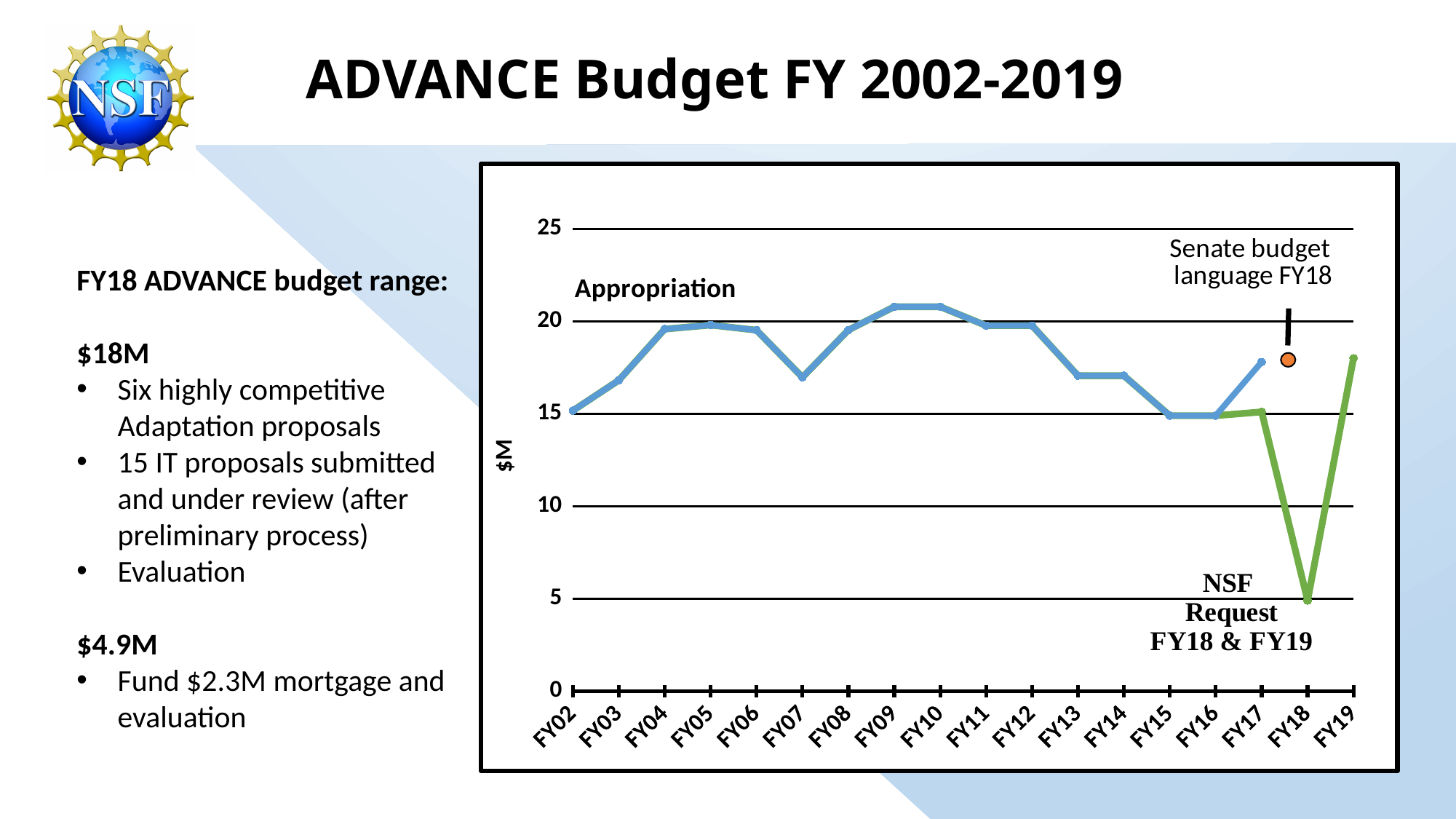
Is the Appropriation value for FY07 greater or less than 20? less Is the NSF Request value for FY19 greater or less than 15? greater Which is larger, the NSF Request for FY18 or for FY19? FY19 How many fiscal years are shown on the x axis of the chart? 18 What kind of chart is shown on the slide? line chart Which is larger, the Appropriation for FY09 or for FY07? FY09 Does the Appropriation line rise or fall from FY12 to FY15? fall Is the Appropriation value for FY09 greater or less than 20? greater What is the label on the y axis of the chart? $M Does the Appropriation line rise or fall from FY02 to FY04? rise What does the orange dot on the chart represent? Senate budget language FY18